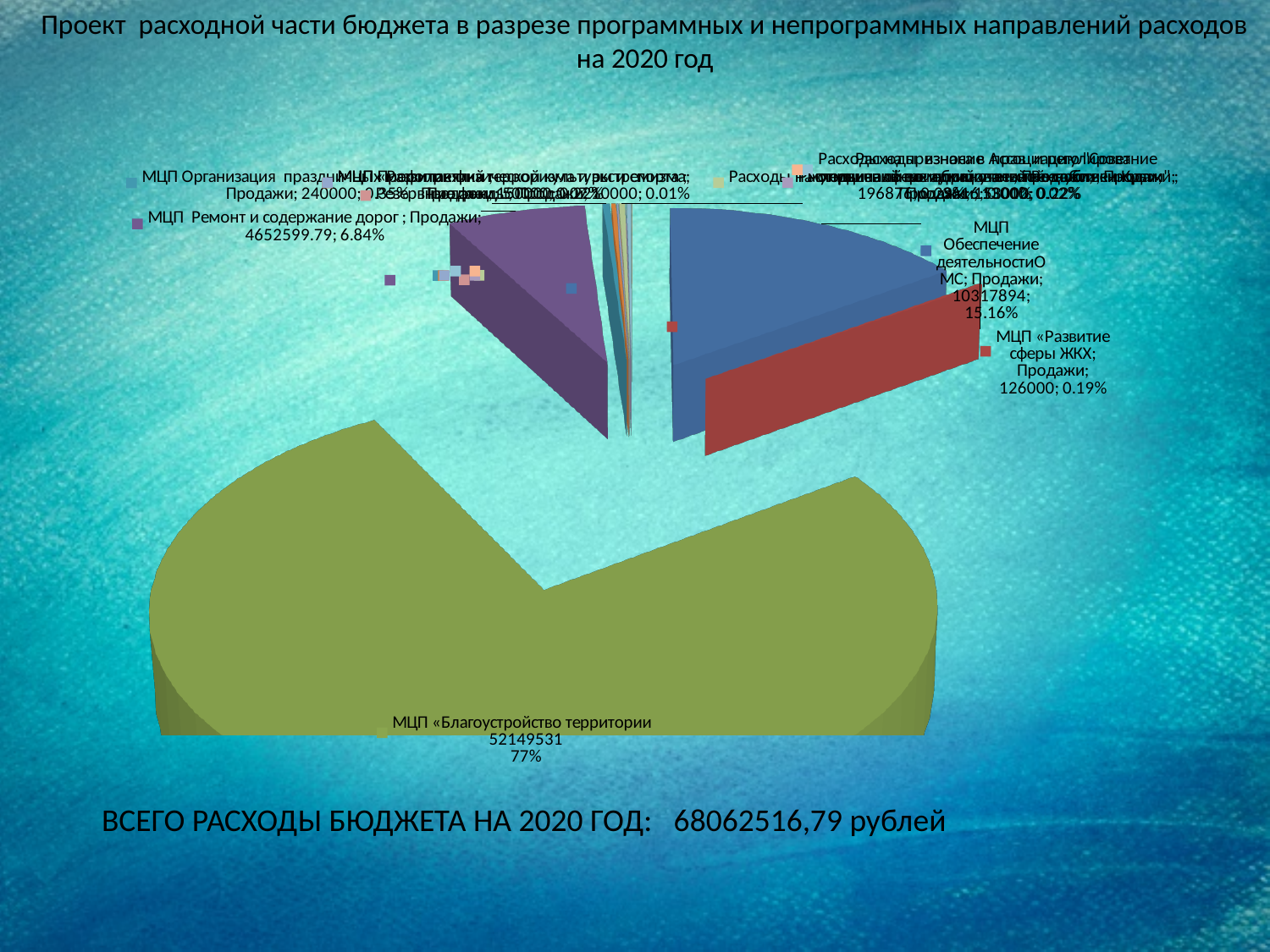
What share of the pie does МЦП «Благоустройство территории account for? 77% What is the value shown for МЦП «Благоустройство территории? 52149531 What is the value shown for МЦП Ремонт и содержание дорог? 4652599.79 What is the value shown for МЦП «Развитие сферы ЖКХ? 126000 What share of the pie does МЦП Обеспечение деятельности ОМС account for? 15.16% What share of the pie does МЦП «Развитие сферы ЖКХ account for? 0.19% What kind of chart is shown on the slide? pie chart Which is larger: the value for МЦП Обеспечение деятельности ОМС or the value for МЦП Ремонт и содержание дорог? МЦП Обеспечение деятельности ОМС What is the difference between the values for МЦП «Благоустройство территории and МЦП Обеспечение деятельности ОМС? 41831637 What is the value shown for МЦП Обеспечение деятельности ОМС? 10317894 What total budget expenditure for 2020 is stated on the slide? 68062516,79 рублей Which category has the largest slice of the pie? МЦП «Благоустройство территории